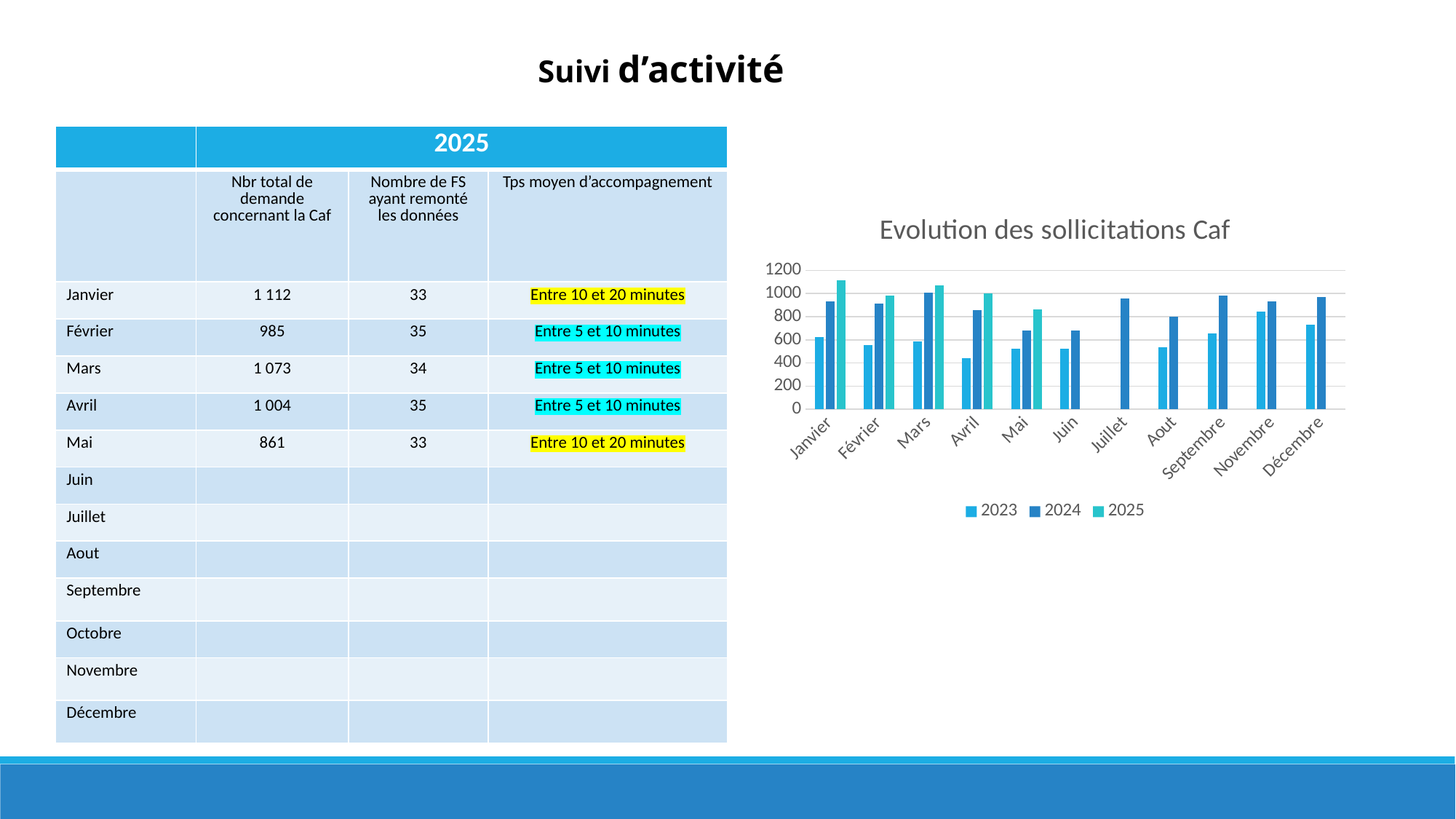
What is the title of the chart on the slide? Evolution des sollicitations Caf How many month categories are shown on the x axis of the chart? 11 In the chart, which month has the highest 2025 value? Janvier In the chart, is the 2023 value for Décembre greater or less than 600? greater In the chart, is the 2025 value for Janvier greater or less than 1000? greater In the chart, is the 2024 value for Juillet greater or less than 800? greater How many series does the legend of the chart list? 3 In the chart, which month has the lowest 2023 value? Avril What type of chart is 'Evolution des sollicitations Caf'? bar chart In the chart, for Avril, which is larger: the 2023 value or the 2024 value? 2024